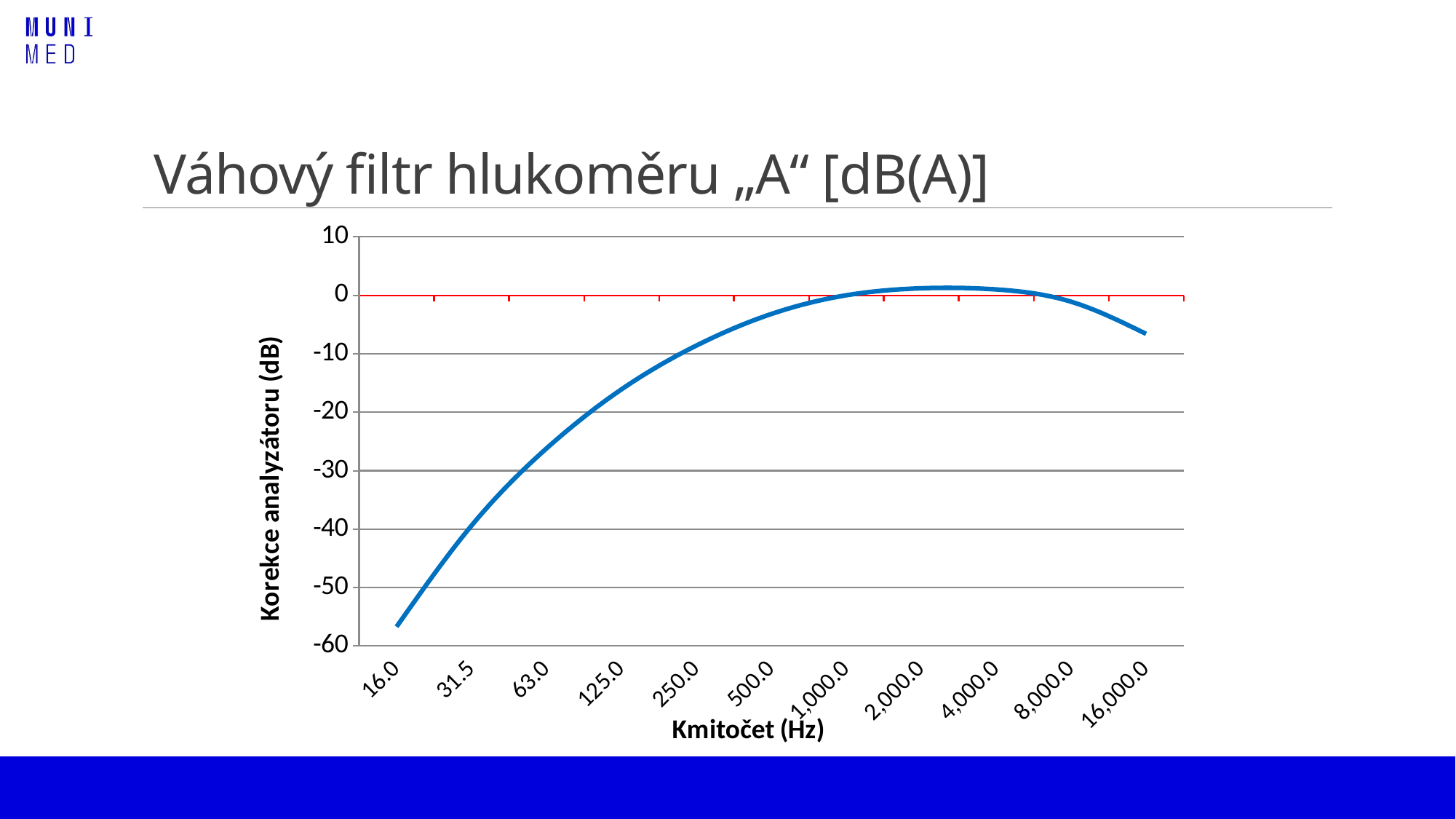
What kind of chart is shown on the slide? line chart Is the correction value at 63.0 Hz greater or less than -20? less How many frequency categories are labelled on the x axis? 11 What is the label of the y axis? Korekce analyzátoru (dB) Does the correction value rise or fall between 16.0 Hz and 1,000.0 Hz? rise Is the correction value at 16,000.0 Hz greater or less than 0? less What is the label of the x axis? Kmitočet (Hz) Which has the larger correction value, 16.0 Hz or 16,000.0 Hz? 16,000.0 Is the correction value at 31.5 Hz greater or less than -30? less Which frequency has the lowest correction value? 16.0